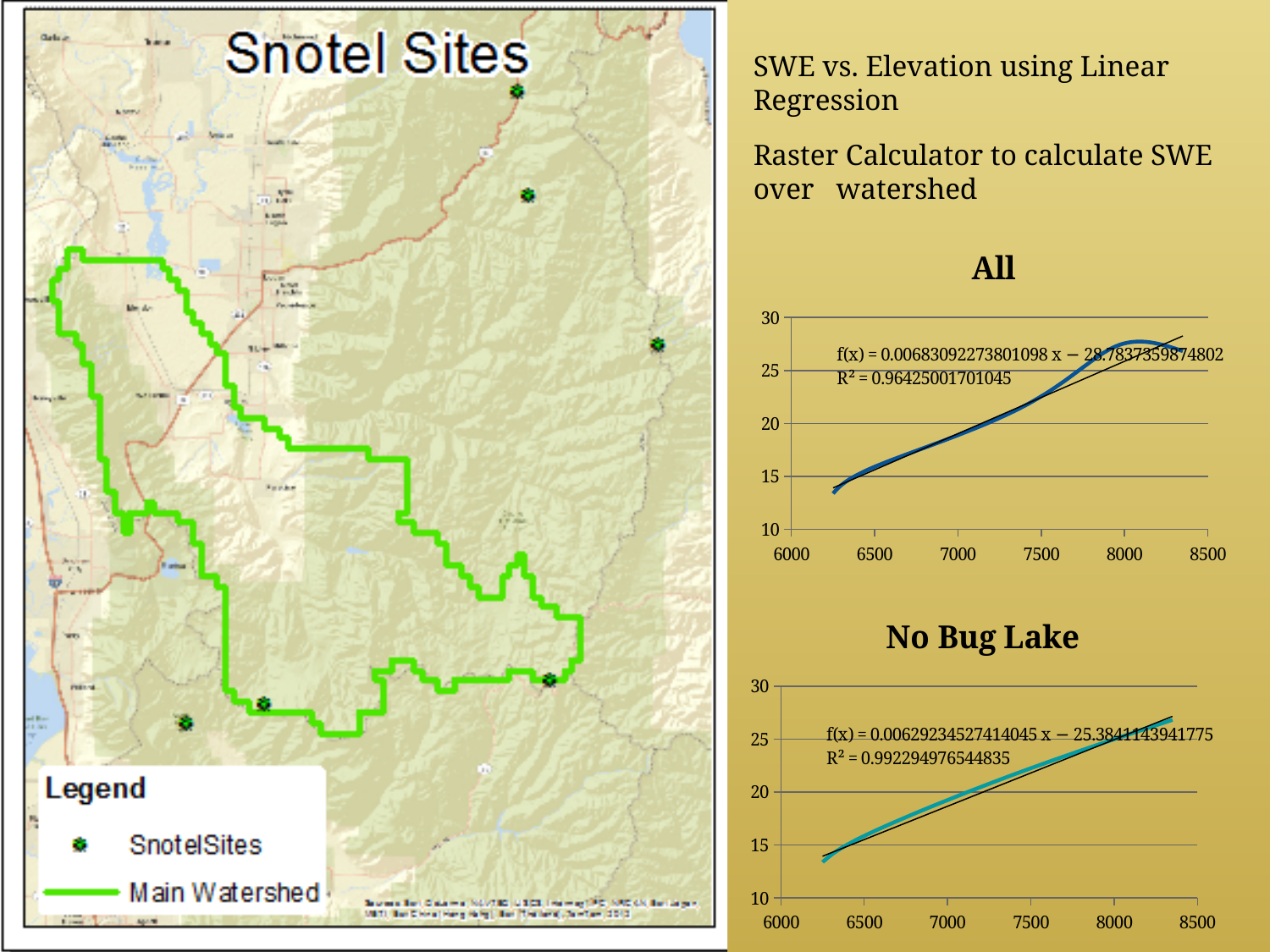
In the "No Bug Lake" chart, do the values rise or fall as elevation increases along the x axis? rise Which chart has the higher R² value, "All" or "No Bug Lake"? No Bug Lake In the "All" chart, is the value at an elevation of 8000 greater or less than 25? greater In the "All" chart, do the values rise or fall as elevation increases along the x axis? rise How many charts are shown on the slide? 2 What is the slope coefficient in the regression equation printed on the "All" chart? 0.00683092273801098 In the "No Bug Lake" chart, is the value at an elevation of 7000 greater or less than 25? less What kind of chart is the "All" chart? line chart What is the R² value printed on the "All" chart? 0.96425001701045 What is the title of the lower chart on the slide? No Bug Lake What is the R² value printed on the "No Bug Lake" chart? 0.992294976544835 What is the slope coefficient in the regression equation printed on the "No Bug Lake" chart? 0.00629234527414045